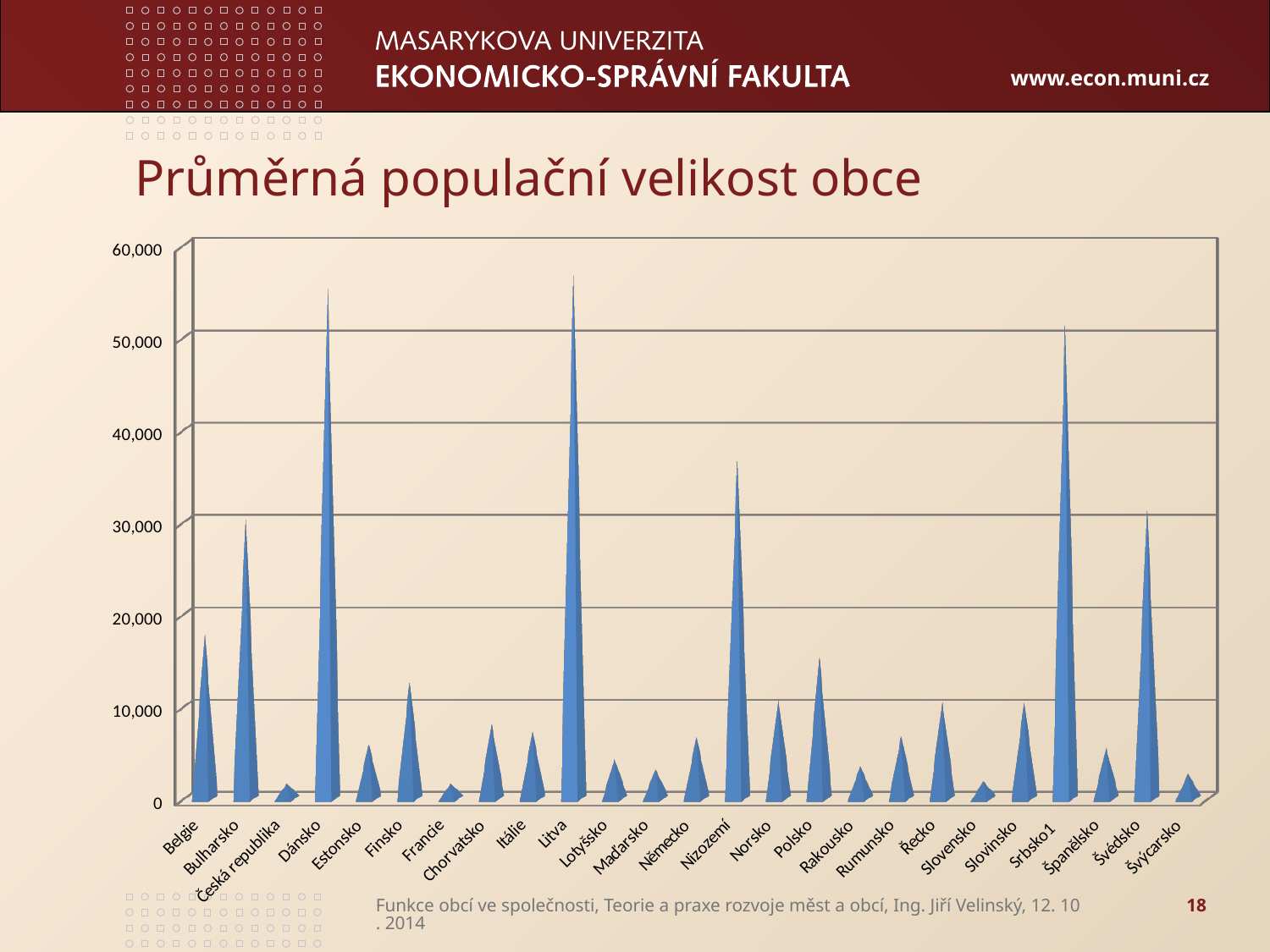
What kind of chart is shown on the slide? bar chart Which has a higher value, Nizozemí or Polsko? Nizozemí Which has a higher value, Dánsko or Belgie? Dánsko How many countries (categories) are shown on the x axis of the chart? 25 What is the title of the chart? Průměrná populační velikost obce Is the value for Srbsko1 greater or less than 40,000? greater Is the value for Litva greater or less than 50,000? greater Is the value for Belgie greater or less than 20,000? less What is the highest value shown on the y axis of the chart? 60,000